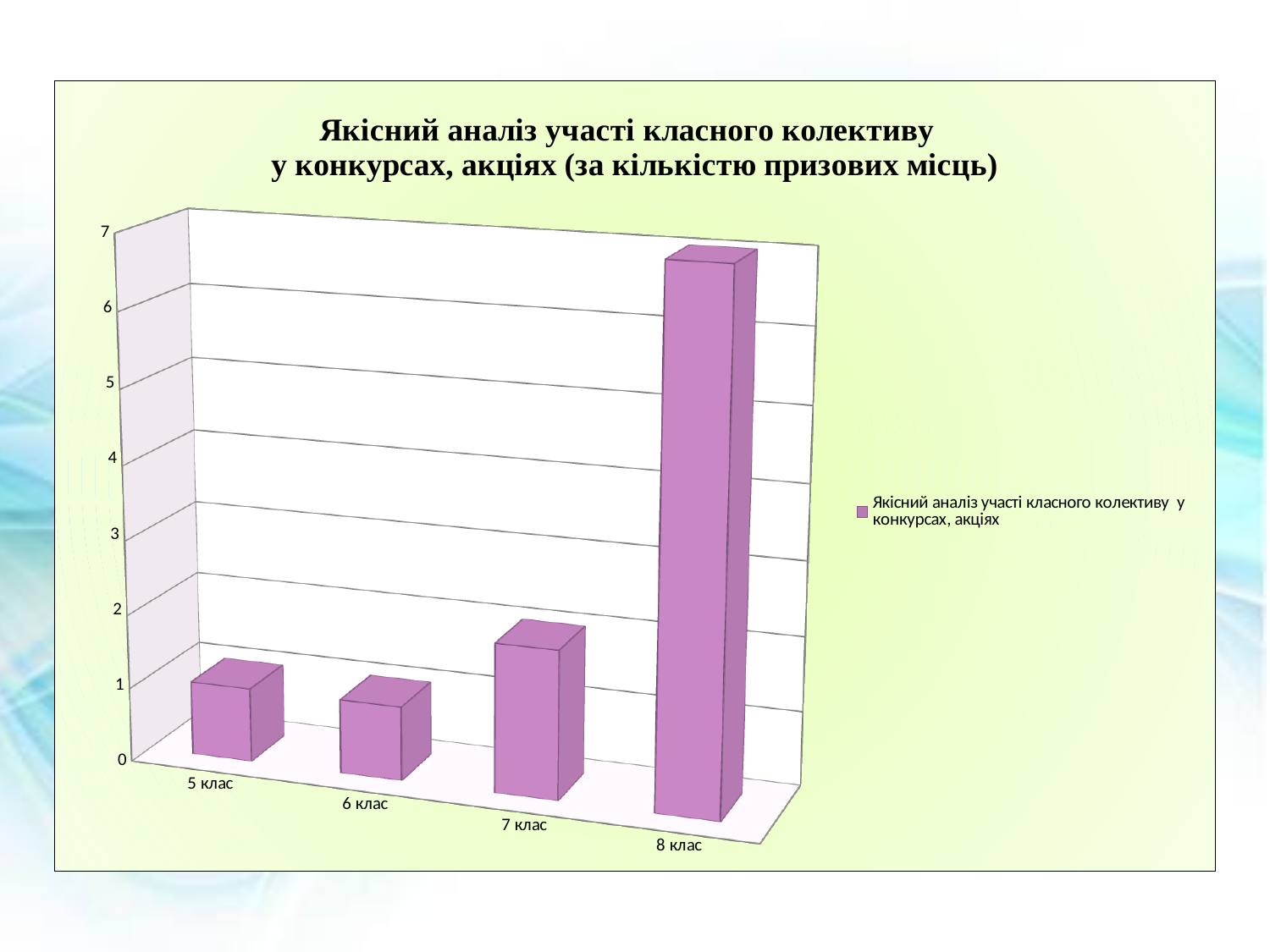
Is the value for 6 клас greater or less than 3? less Is the value for 7 клас greater or less than 3? less What kind of chart is shown on the slide? bar chart Do the values rise or fall from 6 клас to 8 клас along the x axis? rise Is the value for 8 клас greater or less than 5? greater Which has the larger value, 7 клас or 8 клас? 8 клас Which has the larger value, 5 клас or 7 клас? 7 клас How many categories (classes) are shown on the x axis of the chart? 4 Which class has the highest value in the chart? 8 клас How many series does the legend list? 1 What is the title of the chart? Якісний аналіз участі класного колективу у конкурсах, акціях (за кількістю призових місць)